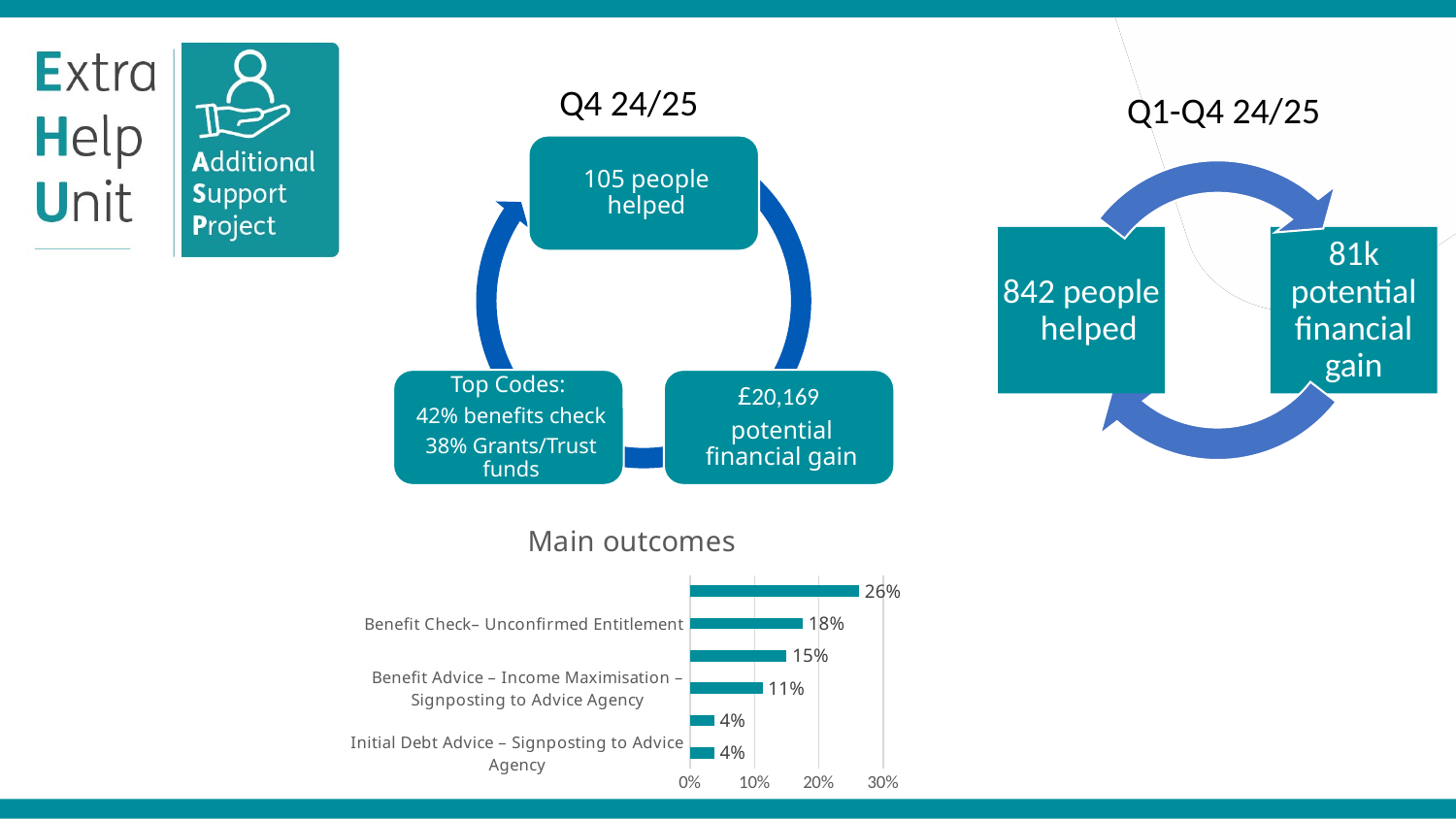
In the Main outcomes chart, what is the value for Benefit Check– Unconfirmed Entitlement? 18% In the Main outcomes chart, what is the difference between Benefit Check– Unconfirmed Entitlement and Benefit Advice – Income Maximisation – Signposting to Advice Agency? 7% How many bars are plotted in the Main outcomes chart? 6 In the Main outcomes chart, what is the highest value shown on any bar? 26% In the Main outcomes chart, what is the value for Benefit Advice – Income Maximisation – Signposting to Advice Agency? 11% In the Main outcomes chart, what is the lowest value shown on any bar? 4% In the Main outcomes chart, is the value for Benefit Check– Unconfirmed Entitlement greater or less than 20%? less In the Main outcomes chart, which is larger: Benefit Check– Unconfirmed Entitlement or Initial Debt Advice – Signposting to Advice Agency? Benefit Check– Unconfirmed Entitlement In the Main outcomes chart, is the value for Benefit Advice – Income Maximisation – Signposting to Advice Agency greater or less than 10%? greater In the Main outcomes chart, what is the value for Initial Debt Advice – Signposting to Advice Agency? 4% What is the maximum value shown on the x axis of the Main outcomes chart? 30% What kind of chart is the Main outcomes chart? bar chart